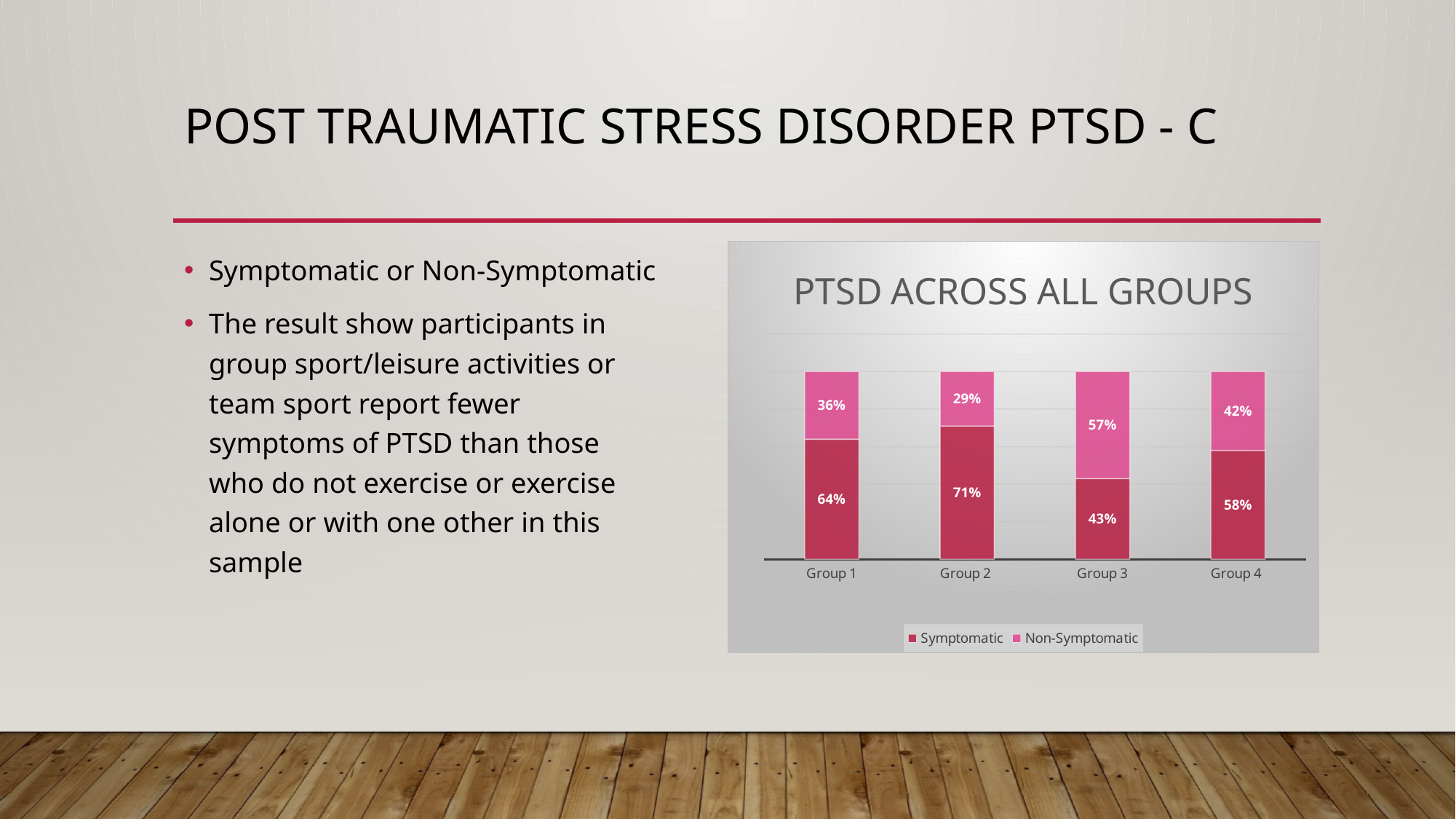
Which group has the lowest Symptomatic value? Group 3 What is the Symptomatic value for Group 1? 64% What kind of chart is shown? Stacked bar chart What is the title of the chart? PTSD ACROSS ALL GROUPS Which group has the highest Symptomatic value? Group 2 What is the Symptomatic value for Group 4? 58% Which is larger for Group 3, the Symptomatic or the Non-Symptomatic value? Non-Symptomatic How many groups are shown on the x axis? 4 What is the difference between the Symptomatic and Non-Symptomatic values for Group 2? 42% Which group has the lowest Non-Symptomatic value? Group 2 How many series does the legend list? 2 What is the Non-Symptomatic value for Group 3? 57%